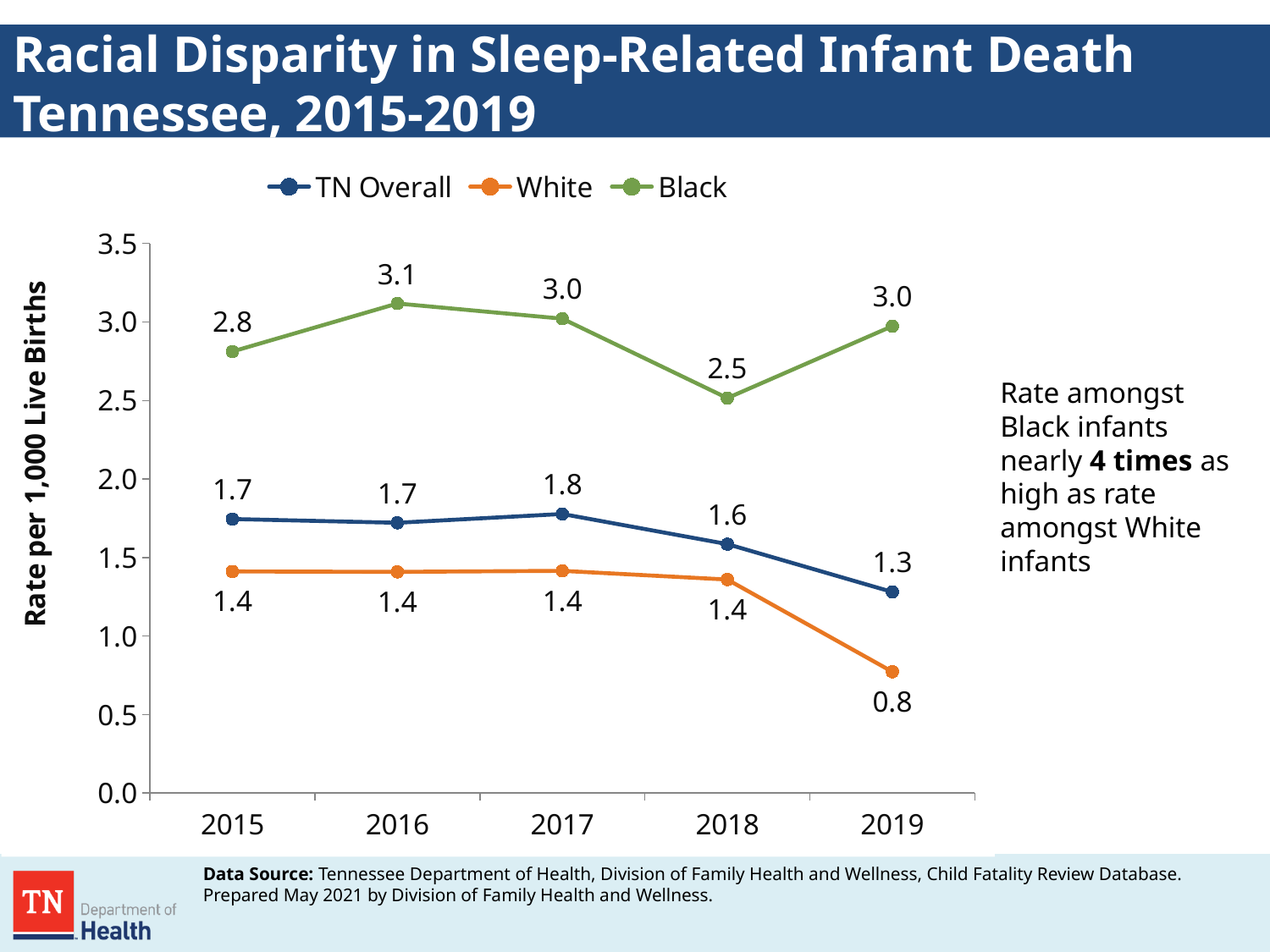
What kind of chart is shown on the slide? line chart How many years are shown on the x axis? 5 Is the rate for Black infants in 2015 greater or less than 2.5? greater In which year is the rate for Black infants lowest? 2018 How many series does the legend list? 3 What is the rate for Black infants in 2016? 3.1 What is the label of the y axis? Rate per 1,000 Live Births What is the rate for White infants in 2019? 0.8 In which year is the rate for Black infants highest? 2016 Which is larger in 2018, the TN Overall rate or the White rate? TN Overall What is the difference between the Black and White rates in 2019? 2.2 What is the TN Overall rate in 2017? 1.8